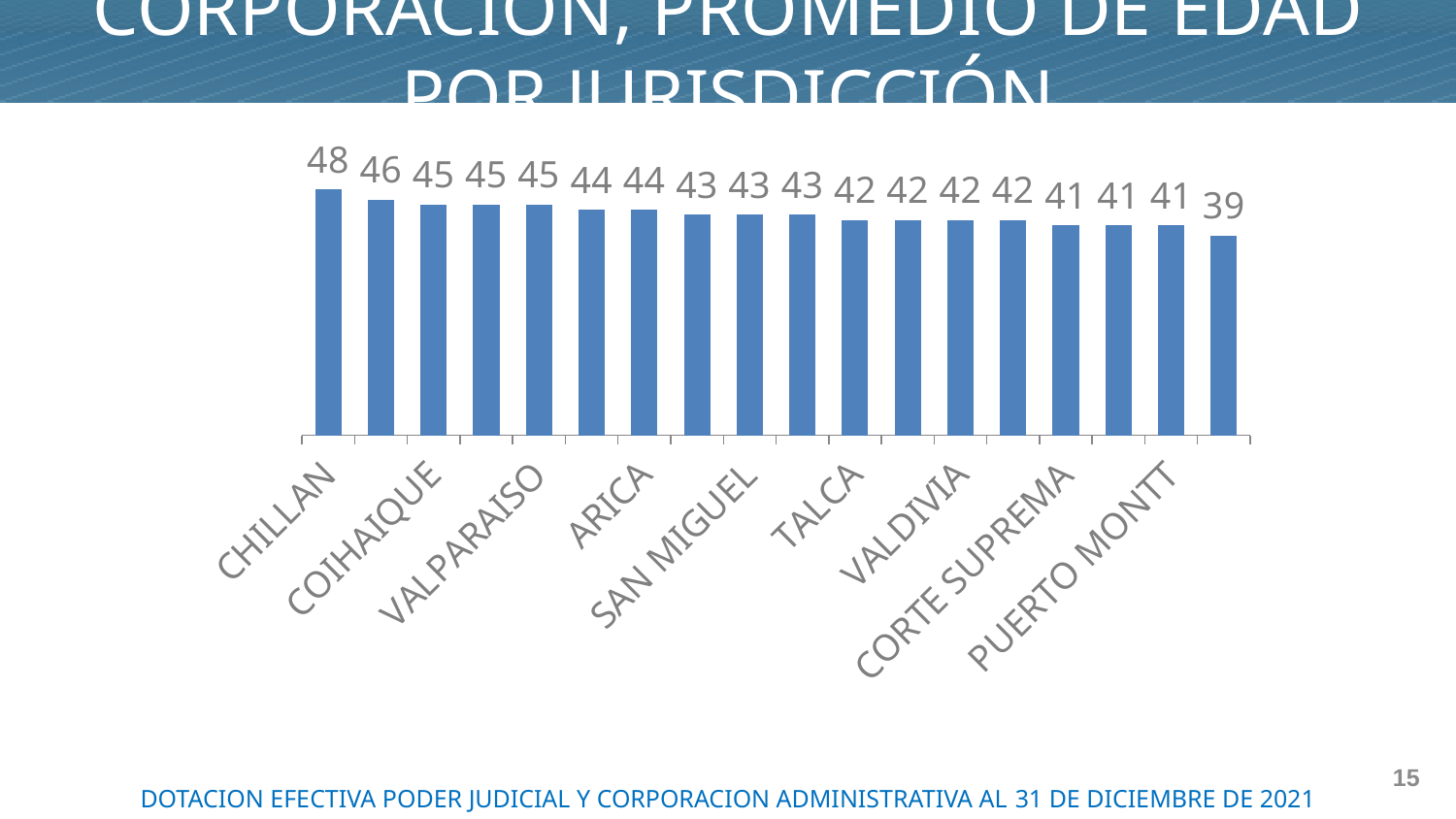
What is the value shown for TALCA? 42 How many bars are plotted on the chart? 18 What is the value shown for SAN MIGUEL? 43 What is the value shown for CORTE SUPREMA? 41 Which labeled jurisdiction has the highest value on the chart? CHILLAN What is the value shown for ARICA? 44 What is the lowest value shown on the chart? 39 What is the difference between the values for CHILLAN and PUERTO MONTT? 7 Do the values rise or fall from left to right along the x axis? Fall What is the average age shown for CHILLAN? 48 Which has a larger value, COIHAIQUE or VALDIVIA? COIHAIQUE What kind of chart is shown on the slide? Bar chart